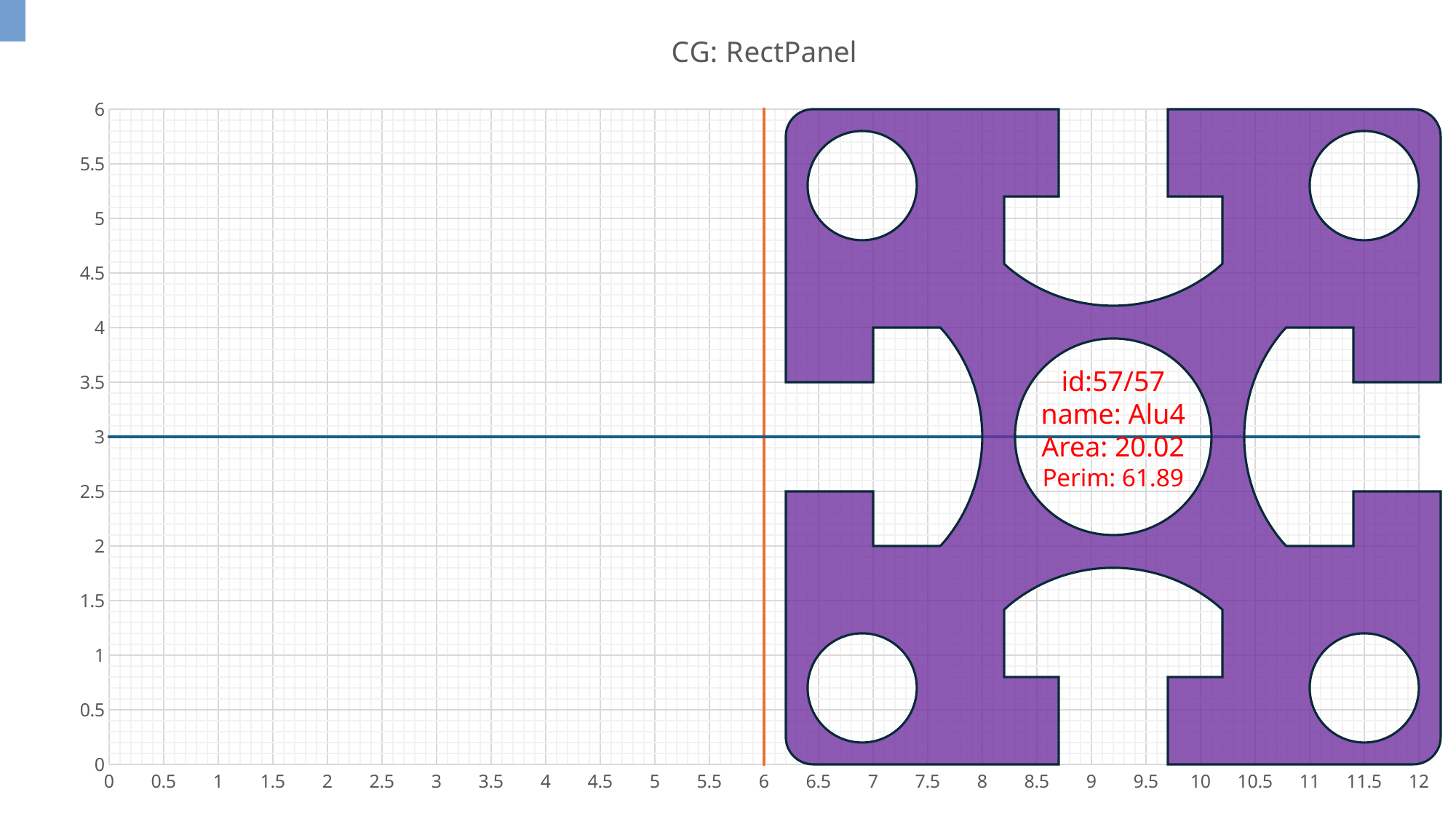
What perimeter value is printed on the shape in the chart? 61.89 At what y value is the horizontal blue line drawn? 3 Is the printed area value greater or less than 20? greater What id is printed on the shape in the chart? 57/57 What area value is printed on the shape in the chart? 20.02 At what x value is the vertical orange line drawn? 6 How many circular holes are cut into the purple shape? 5 What name is printed on the shape in the chart? Alu4 Which printed value is larger, the area or the perimeter? Perimeter Is the printed perimeter value greater or less than 60? greater What is the title of the chart? CG: RectPanel What is the maximum value shown on the x axis? 12